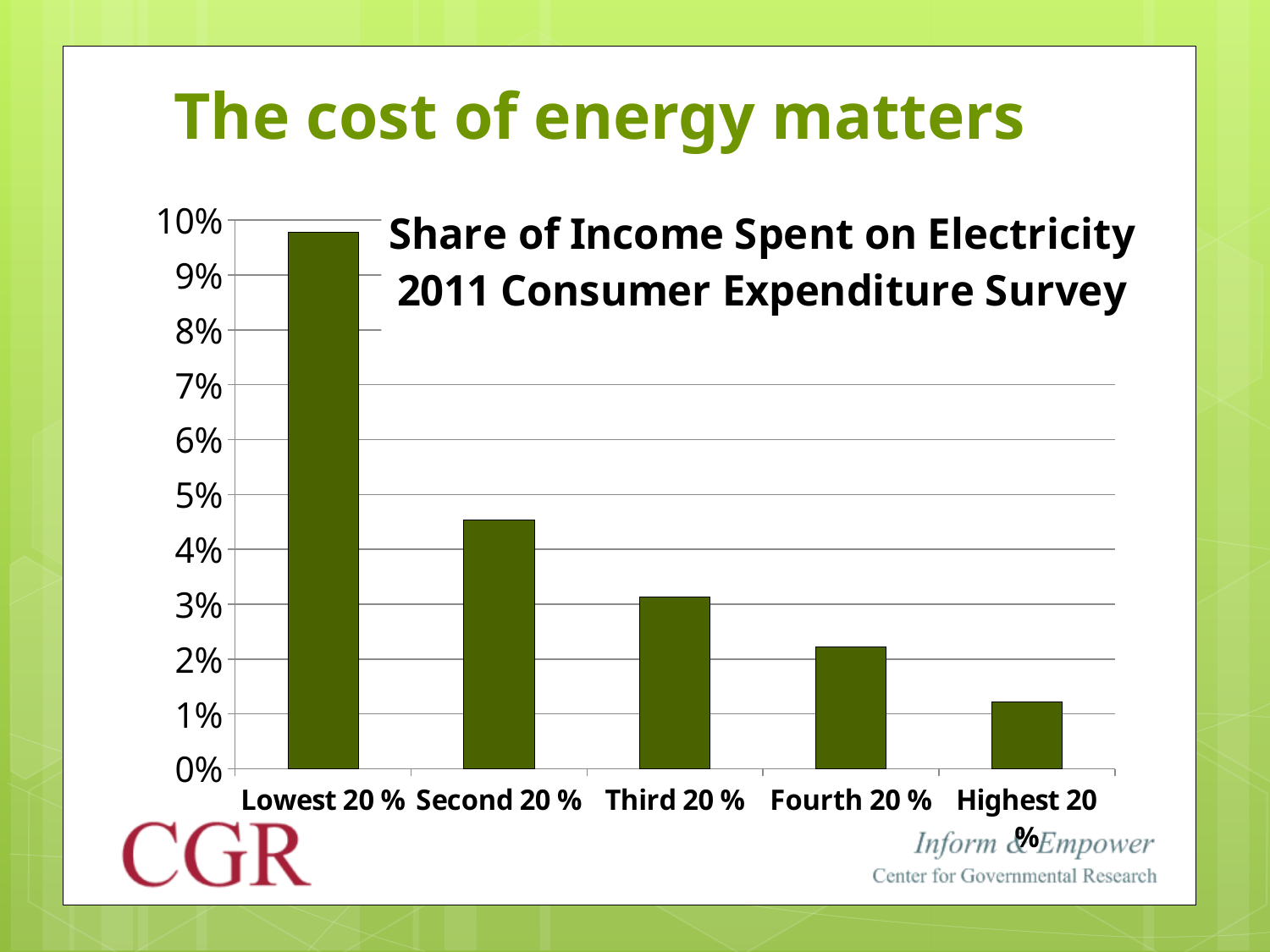
How many income groups are shown on the x axis of the chart? 5 Is the value for Third 20 % greater or less than 4%? less Which is larger, the value for Second 20 % or the value for Third 20 %? Second 20 % Which income group has the lowest share of income spent on electricity? Highest 20 % Do the values rise or fall moving from Lowest 20 % to Highest 20 % along the x axis? fall What is the title of the chart? Share of Income Spent on Electricity 2011 Consumer Expenditure Survey Is the value for Fourth 20 % greater or less than 2%? greater Which income group has the highest share of income spent on electricity? Lowest 20 % What kind of chart is shown on the slide? bar chart Is the value for Second 20 % greater or less than 4%? greater